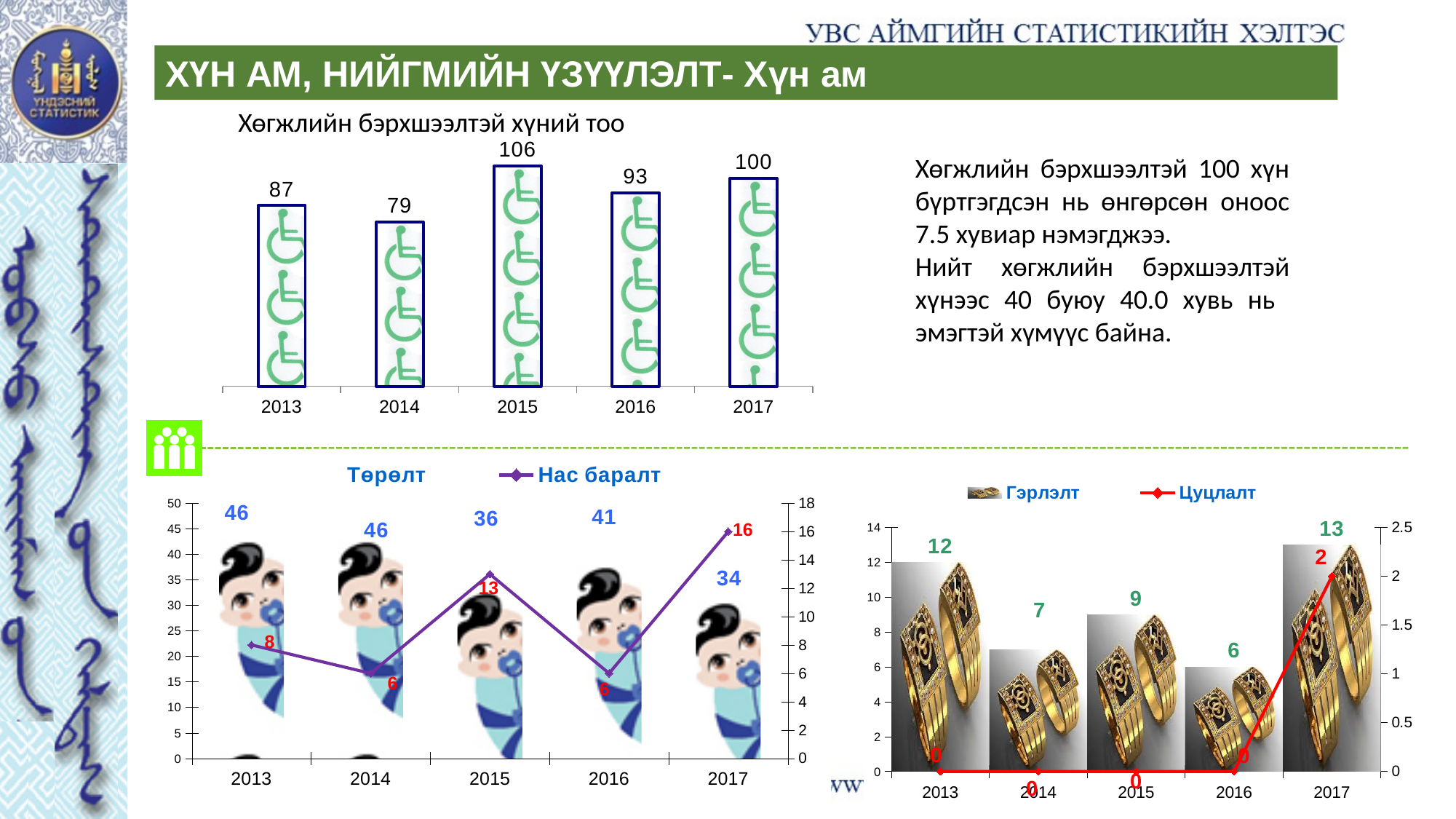
In the bottom-right chart, what is the Цуцлалт value for 2017? 2 In the bottom-left chart, how many series does the legend list? 2 In the bottom-left chart, which year has the highest Нас баралт value? 2017 In the chart 'Хөгжлийн бэрхшээлтэй хүний тоо', what is the value for 2015? 106 In the bottom-right chart, what is the Гэрлэлт value for 2014? 7 In the chart 'Хөгжлийн бэрхшээлтэй хүний тоо', which year has the lowest value? 2014 In the bottom-left chart, what is the Төрөлт value for 2016? 41 In the chart 'Хөгжлийн бэрхшээлтэй хүний тоо', how many years are shown on the x axis? 5 In the chart 'Хөгжлийн бэрхшээлтэй хүний тоо', what is the difference between the 2017 and 2016 values? 7 In the bottom-right chart, which year has the highest Гэрлэлт value? 2017 What kind of chart is 'Хөгжлийн бэрхшээлтэй хүний тоо'? bar chart In the bottom-left chart, what is the Нас баралт value for 2017? 16